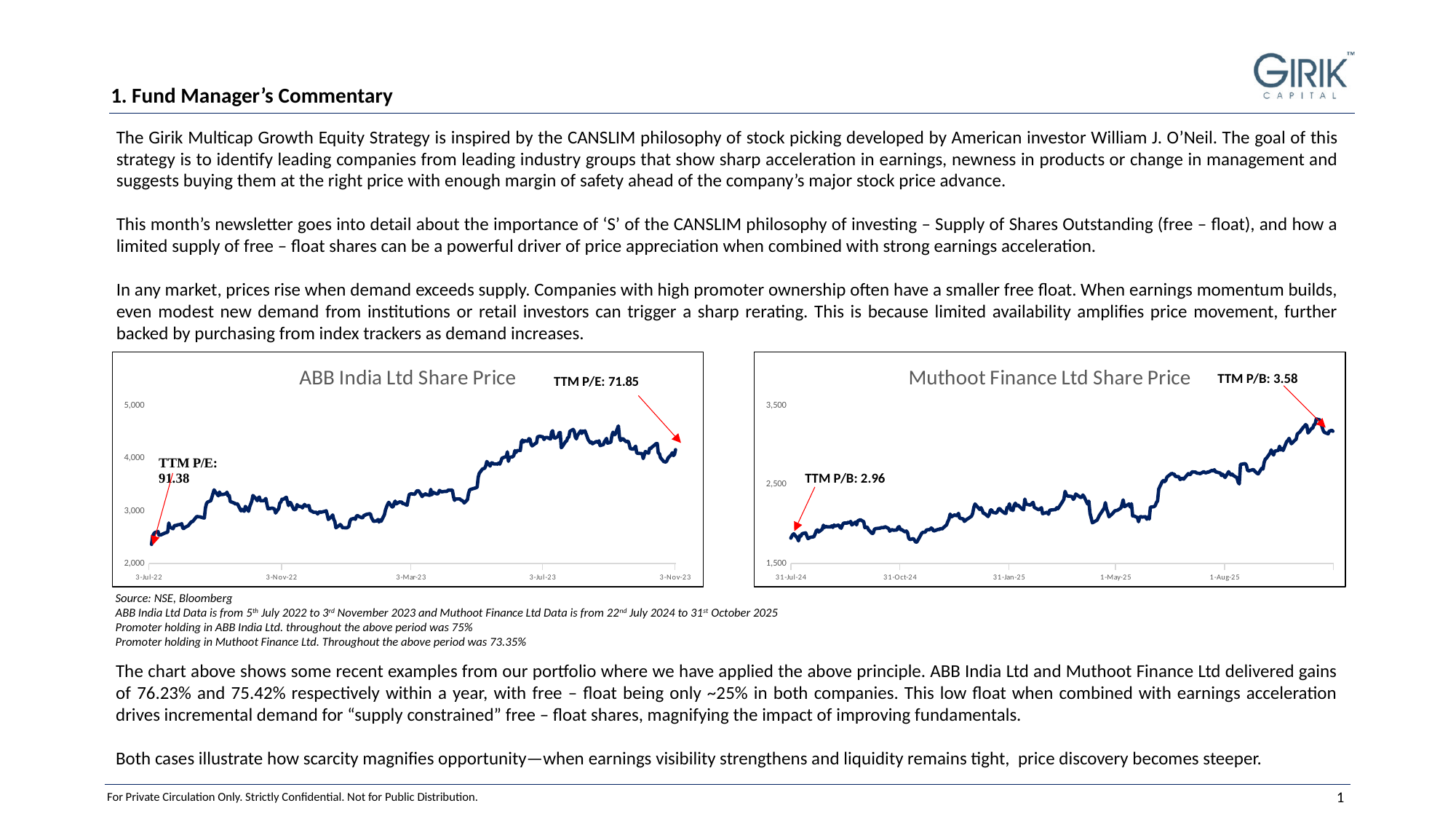
What kind of chart is the ABB India Ltd Share Price chart? line chart How many date labels are shown on the x axis of the ABB India Ltd Share Price chart? 5 In the Muthoot Finance Ltd Share Price chart, what TTM P/B is annotated at the end of the period? 3.58 In the ABB India Ltd Share Price chart, does the share price overall rise or fall from 3-Jul-22 to 3-Nov-23? rise In the Muthoot Finance Ltd Share Price chart, what TTM P/B is annotated at the start of the period? 2.96 In the ABB India Ltd Share Price chart, what TTM P/E is annotated at the start of the period? 91.38 What kind of chart is the Muthoot Finance Ltd Share Price chart? line chart In the Muthoot Finance Ltd Share Price chart, is the share price at 31-Jul-24 greater or less than 2,500? less In the ABB India Ltd Share Price chart, what TTM P/E is annotated at the end of the period? 71.85 In the Muthoot Finance Ltd Share Price chart, is the share price at the end of the period greater or less than 3,000? greater In the ABB India Ltd Share Price chart, is the share price at 3-Jul-22 greater or less than 3,000? less In the Muthoot Finance Ltd Share Price chart, does the share price overall rise or fall from 31-Jul-24 to the end of the period? rise